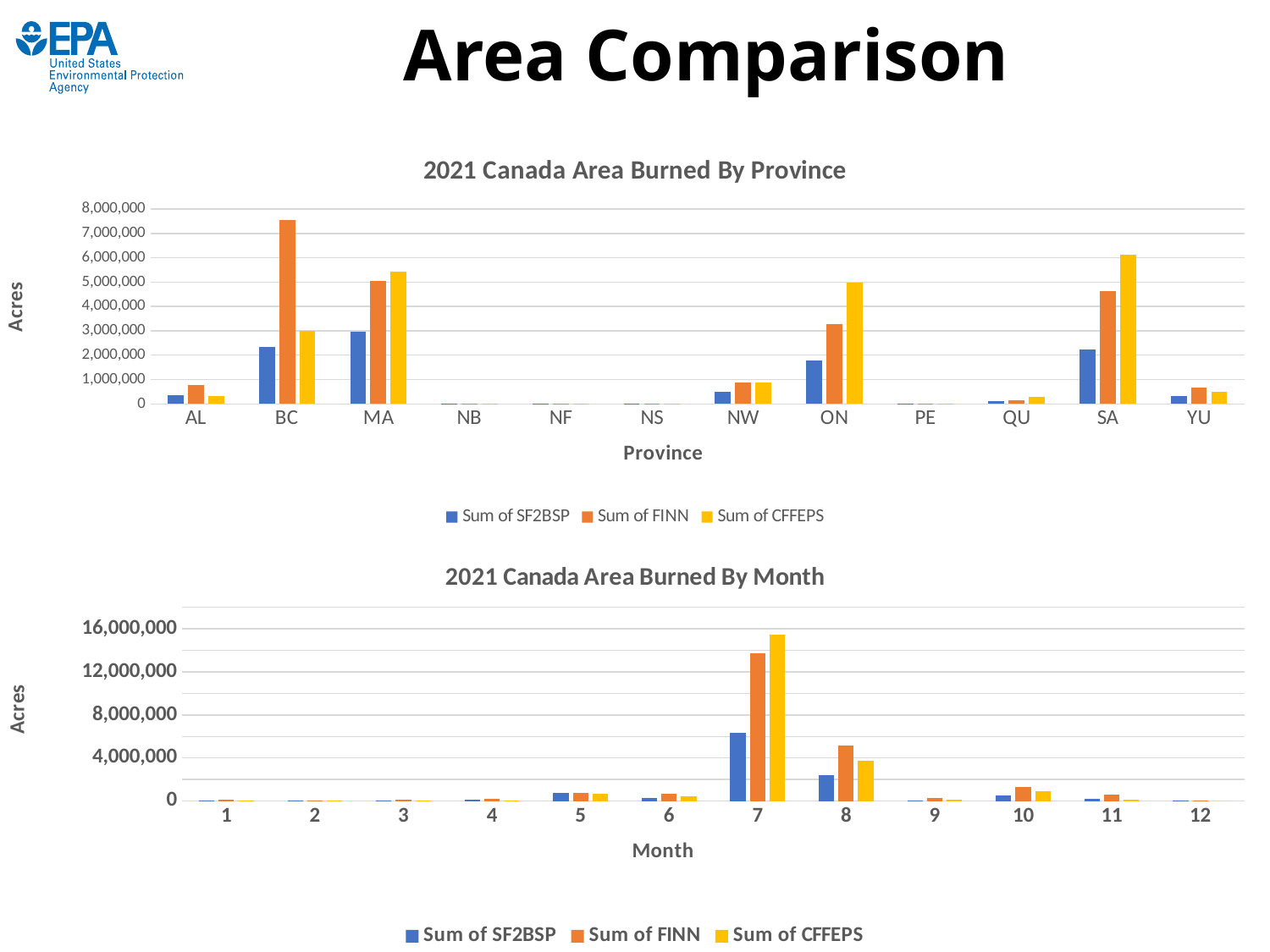
In the '2021 Canada Area Burned By Province' chart, which province has the highest Sum of SF2BSP value? MA In the '2021 Canada Area Burned By Province' chart, which province has the highest Sum of CFFEPS value? SA In the '2021 Canada Area Burned By Month' chart, which month has the highest Sum of CFFEPS value? 7 In the '2021 Canada Area Burned By Province' chart, is the Sum of FINN value for BC greater or less than 7,000,000? greater What type of chart is the '2021 Canada Area Burned By Month' chart? Bar chart How many series does the legend of the '2021 Canada Area Burned By Month' chart list? 3 In the '2021 Canada Area Burned By Province' chart, is the Sum of CFFEPS value for MA greater or less than 5,000,000? greater How many provinces are shown on the x axis of the '2021 Canada Area Burned By Province' chart? 12 In the '2021 Canada Area Burned By Month' chart, which is larger for month 7: Sum of SF2BSP or Sum of CFFEPS? Sum of CFFEPS In the '2021 Canada Area Burned By Month' chart, is the Sum of FINN value for month 7 greater or less than 12,000,000? greater In the '2021 Canada Area Burned By Province' chart, which is larger for SA: Sum of FINN or Sum of CFFEPS? Sum of CFFEPS